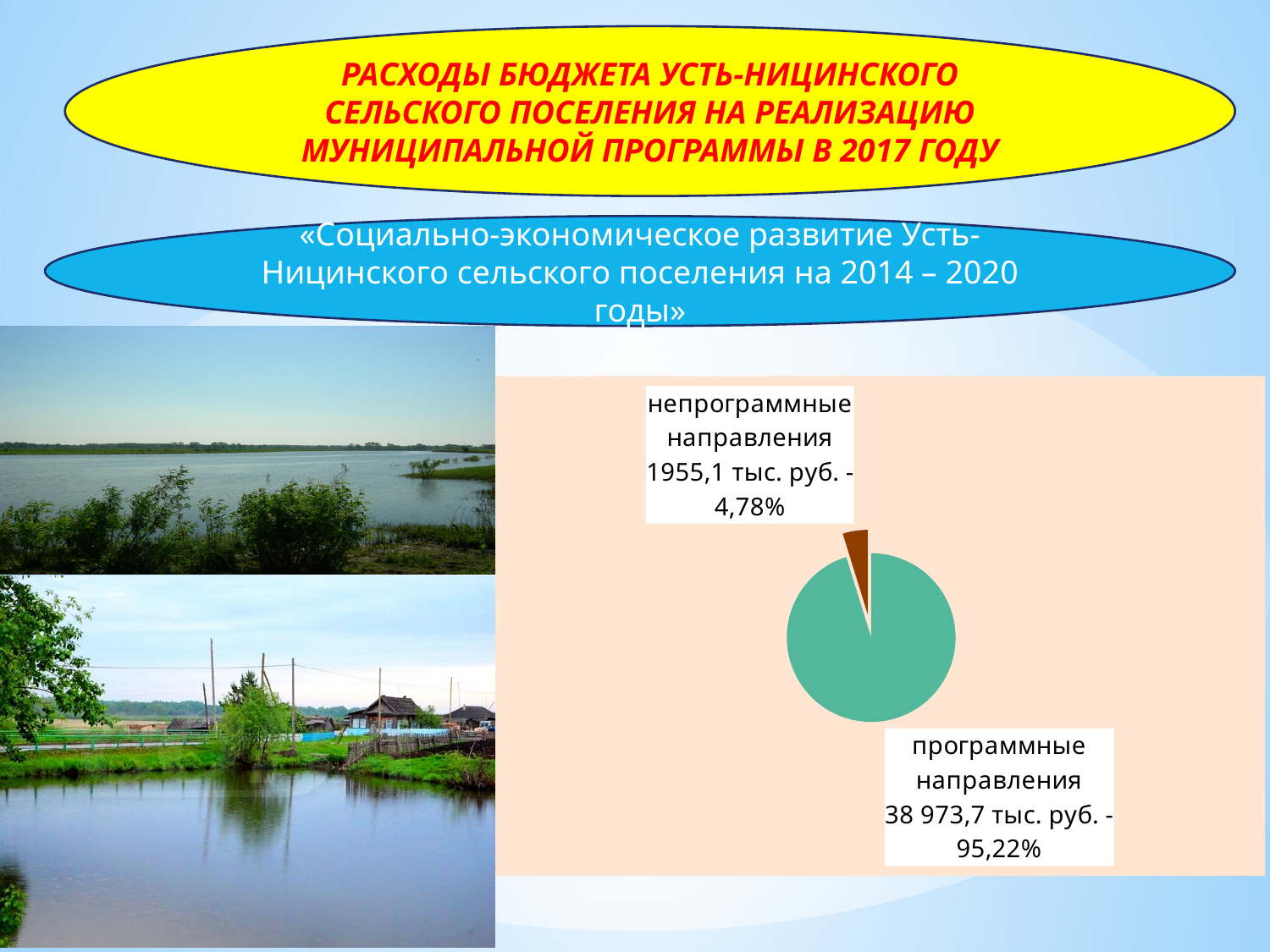
What is the difference between the values for программные направления and непрограммные направления? 37 018,6 тыс. руб. What is the value for программные направления in the pie chart? 38 973,7 тыс. руб. Which slice of the pie chart is the largest? программные направления What kind of chart is shown on the slide? pie chart What colour is the slice for непрограммные направления? brown What share of the pie does непрограммные направления represent? 4,78% What is the value for непрограммные направления in the pie chart? 1955,1 тыс. руб. Which slice of the pie chart is the smallest? непрограммные направления What is the total of the two values shown in the pie chart? 40 928,8 тыс. руб. How many slices does the pie chart have? 2 What share of the pie does программные направления represent? 95,22% Which is larger: программные направления or непрограммные направления? программные направления